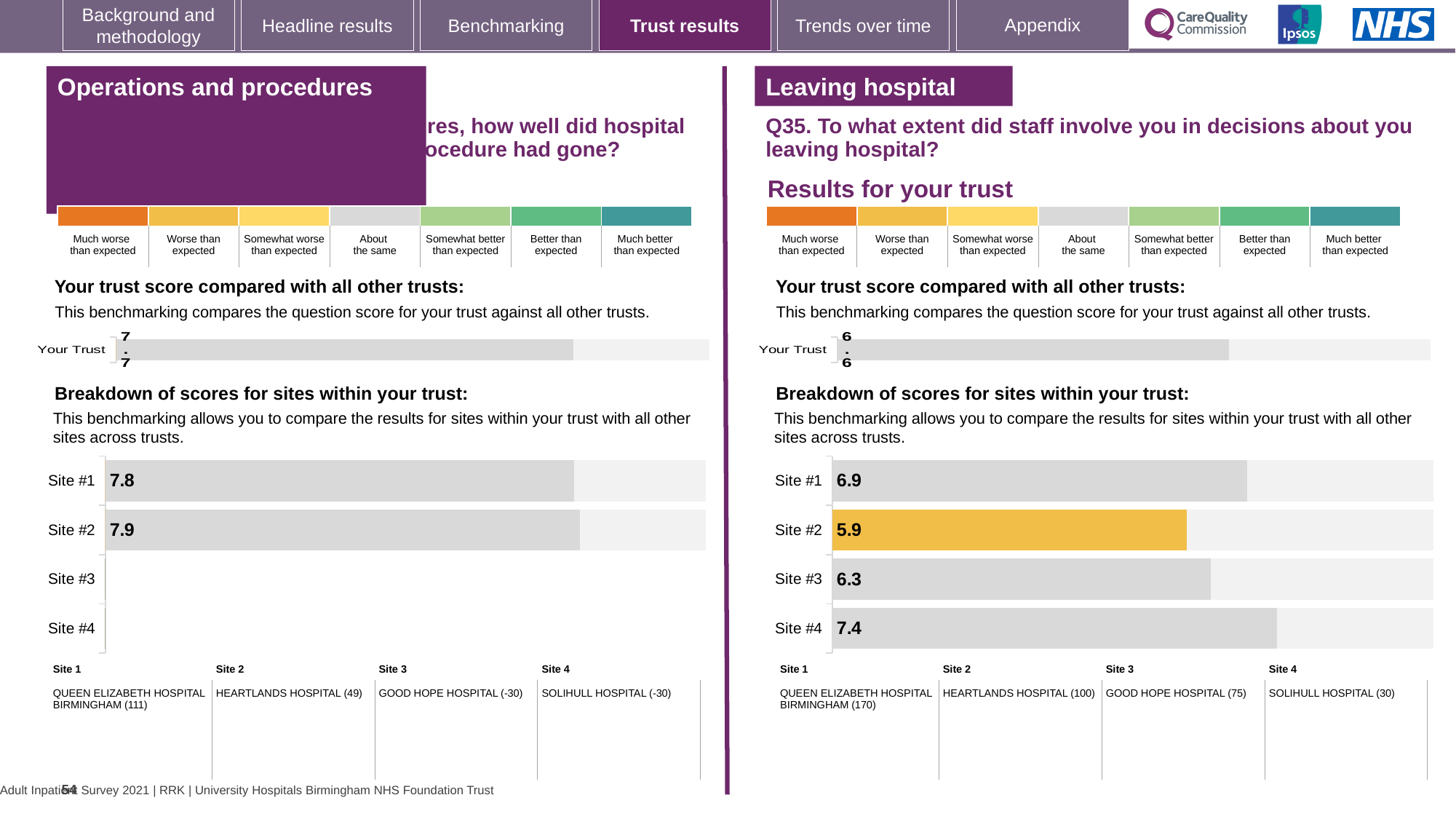
In the 'Leaving hospital' 'Your Trust' chart on the right, what is the trust score? 6.6 In the 'Operations and procedures' site breakdown chart on the left, what is the difference between the scores for Site #2 and Site #1? 0.1 In the 'Operations and procedures' site breakdown chart on the left, which has the higher score, Site #1 or Site #2? Site #2 In the 'Leaving hospital' site breakdown chart on the right, what is the difference between the scores for Site #4 and Site #2? 1.5 In the 'Leaving hospital' site breakdown chart on the right, which site has the lowest score? Site #2 In the 'Leaving hospital' site breakdown chart on the right, what is the score for Site #4? 7.4 In the 'Leaving hospital' site breakdown chart on the right, which site has the highest score? Site #4 In the 'Leaving hospital' site breakdown chart on the right, what is the score for Site #2? 5.9 In the 'Leaving hospital' site breakdown chart on the right, how many sites are listed? 4 In the 'Operations and procedures' site breakdown chart on the left, what is the score for Site #1? 7.8 In the 'Operations and procedures' 'Your Trust' chart on the left, what is the trust score? 7.7 In the 'Leaving hospital' site breakdown chart on the right, which site's bar is coloured yellow rather than grey? Site #2